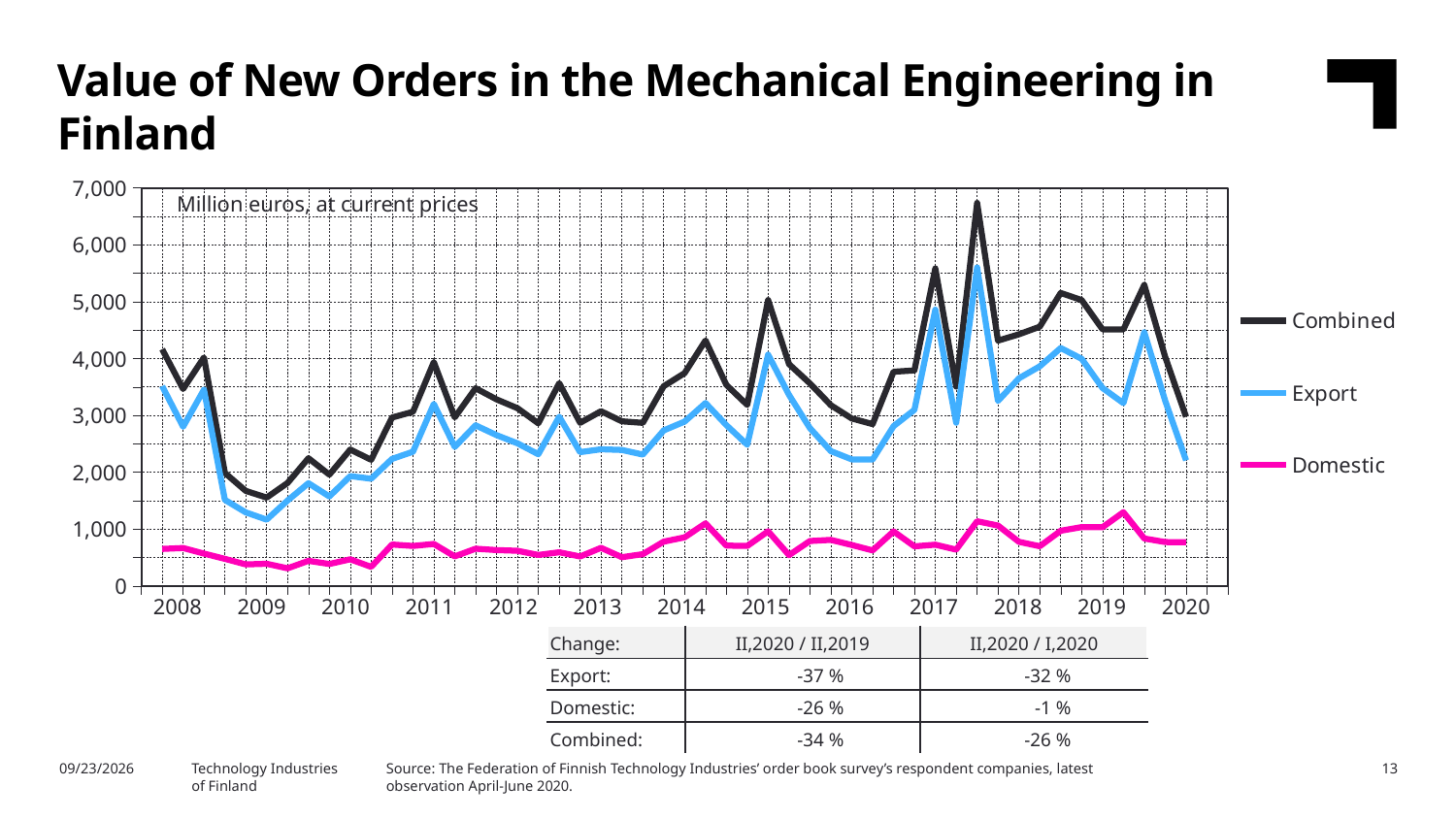
Which series has the highest values throughout the chart? Combined How many years are labelled on the x axis? 13 What unit is stated in the label inside the chart area? Million euros, at current prices What kind of chart is shown on the slide? Line chart How many series does the chart legend list? 3 Is the peak value of the Combined series in 2017 greater or less than 6,000? greater Is the value of the Domestic series at the start of 2008 greater or less than 1,000? less Is the lowest value of the Combined series in 2009 greater or less than 2,000? less Which series are listed in the chart legend? Combined, Export, Domestic Which is larger in 2015, the Export series or the Domestic series? Export Which series has the lowest values throughout the chart? Domestic Does the Combined series rise or fall from 2008 to 2009? Fall